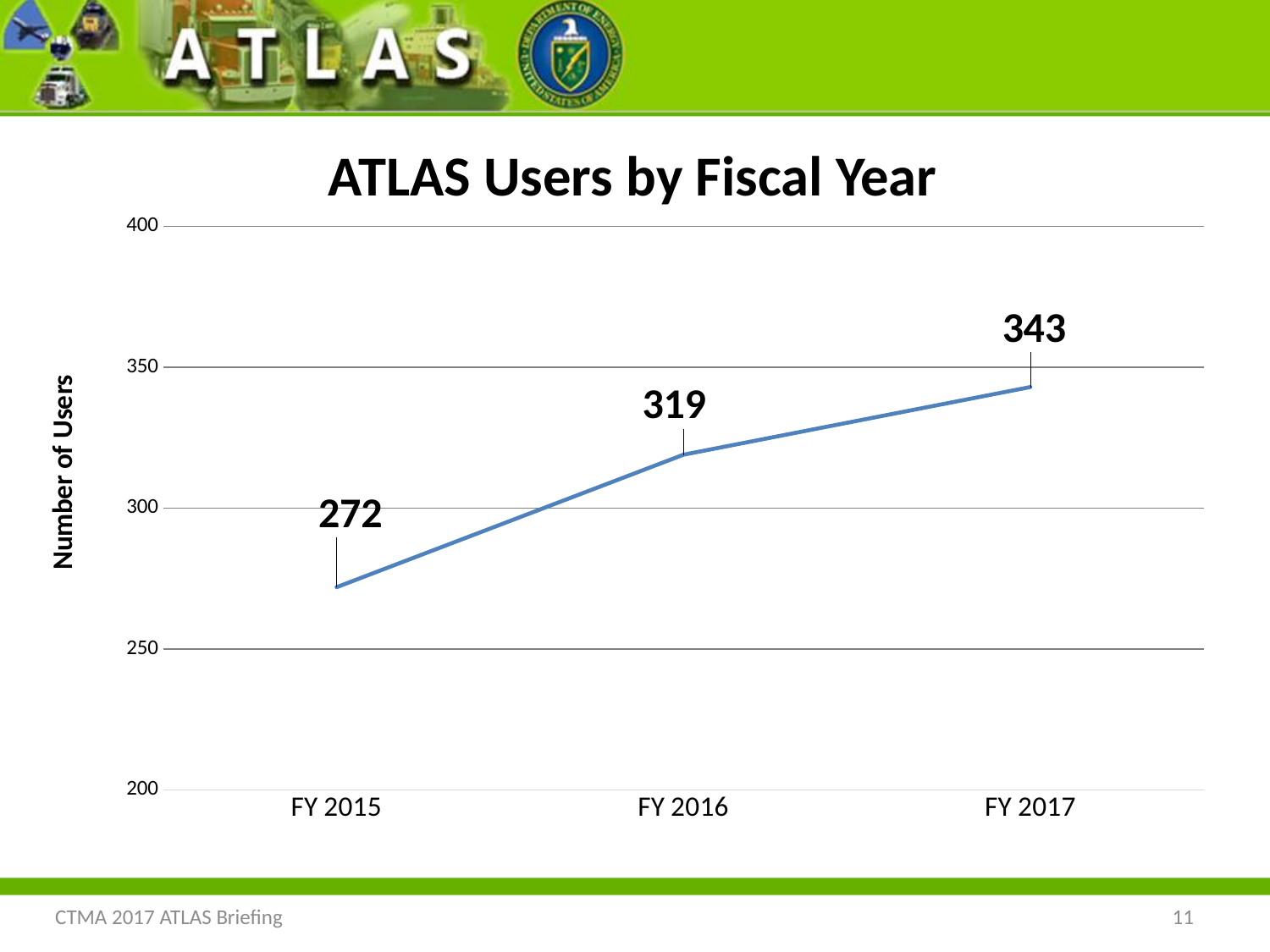
Which fiscal year has the lowest number of users? FY 2015 What kind of chart is shown on the slide? line chart Is the number of users in FY 2016 greater or less than 300? greater What is the difference in the number of users between FY 2016 and FY 2015? 47 What is the number of ATLAS users in FY 2015? 272 What is the number of ATLAS users in FY 2016? 319 Which fiscal year has the highest number of users? FY 2017 What is the difference in the number of users between FY 2017 and FY 2015? 71 Does the number of users rise or fall from FY 2015 to FY 2017? rise How many fiscal years are plotted on the chart? 3 Which has more users, FY 2016 or FY 2017? FY 2017 What is the number of ATLAS users in FY 2017? 343